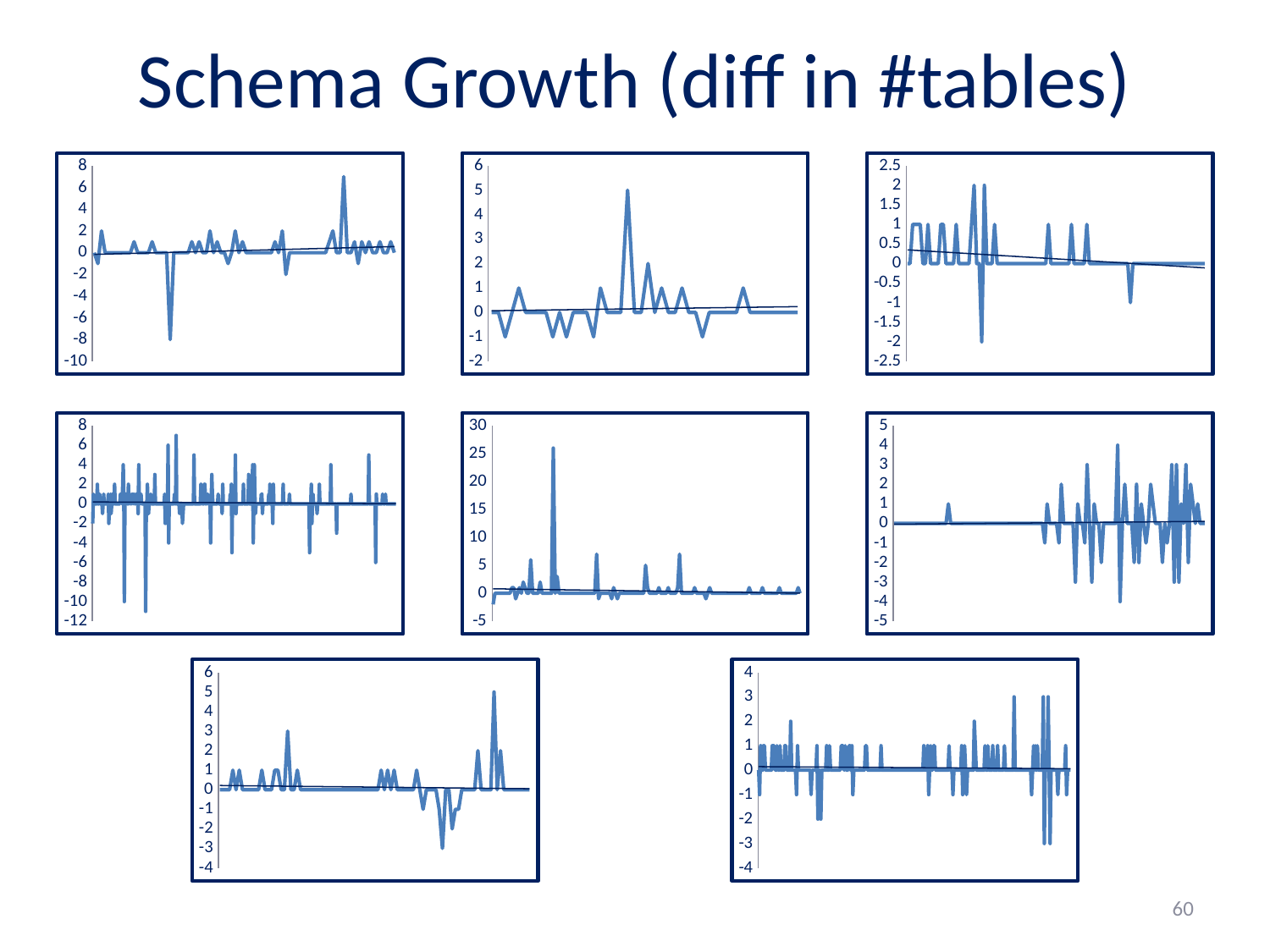
What kind of chart is the top-left chart on the slide? line chart In the top-left chart, is the lowest value greater or less than -6? less What is the maximum value shown on the y axis of the middle chart in the middle row? 30 In the middle-left chart, is the lowest value greater or less than -8? less What is the minimum value shown on the y axis of the middle-left chart? -12 In the top-right chart, does the straight trend line rise or fall along the x axis? fall In the top-middle chart, is the highest peak greater or less than 4? greater How many charts are shown on the slide? 8